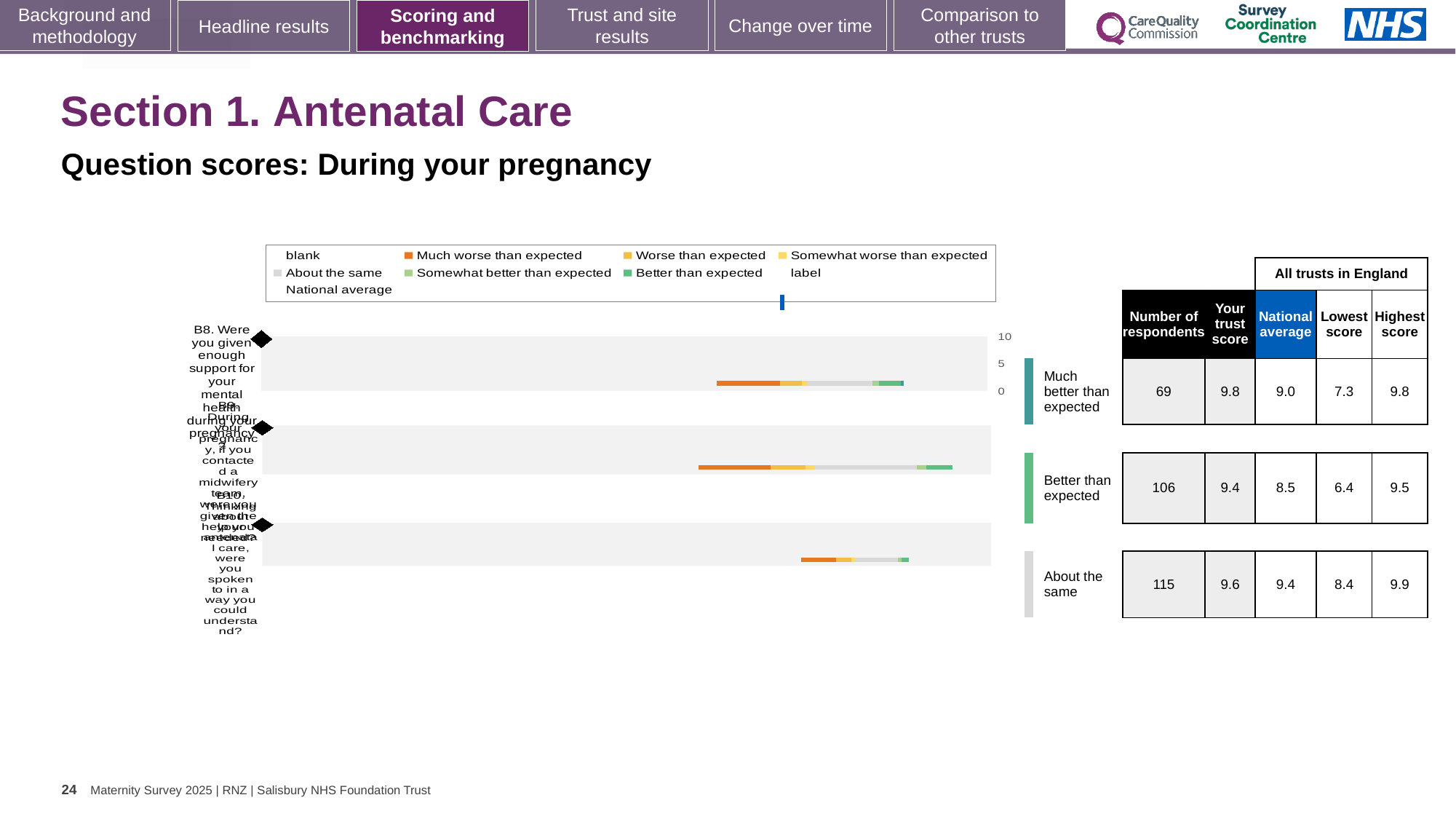
In the table beside the chart, what is 'Your trust score' for the row rated 'Better than expected'? 9.4 In the table beside the chart, what is the number of respondents for the row rated 'Much better than expected'? 69 In the table beside the chart, which row has the highest number of respondents? About the same How many question bars are plotted in the chart? 3 What colour does the legend use for 'Much worse than expected'? orange In the table beside the chart, which is larger: the highest score for the 'About the same' row or the highest score for the 'Better than expected' row? About the same In the table beside the chart, what is the difference between 'Your trust score' and the national average for the row rated 'Much better than expected'? 0.8 In the table beside the chart, which row has the lowest 'Lowest score' across all trusts in England? Better than expected What is the subtitle above the chart? Question scores: During your pregnancy How many entries does the chart legend list? 9 In the table beside the chart, what is the national average for the row rated 'About the same'? 9.4 What kind of chart is shown on the slide? bar chart